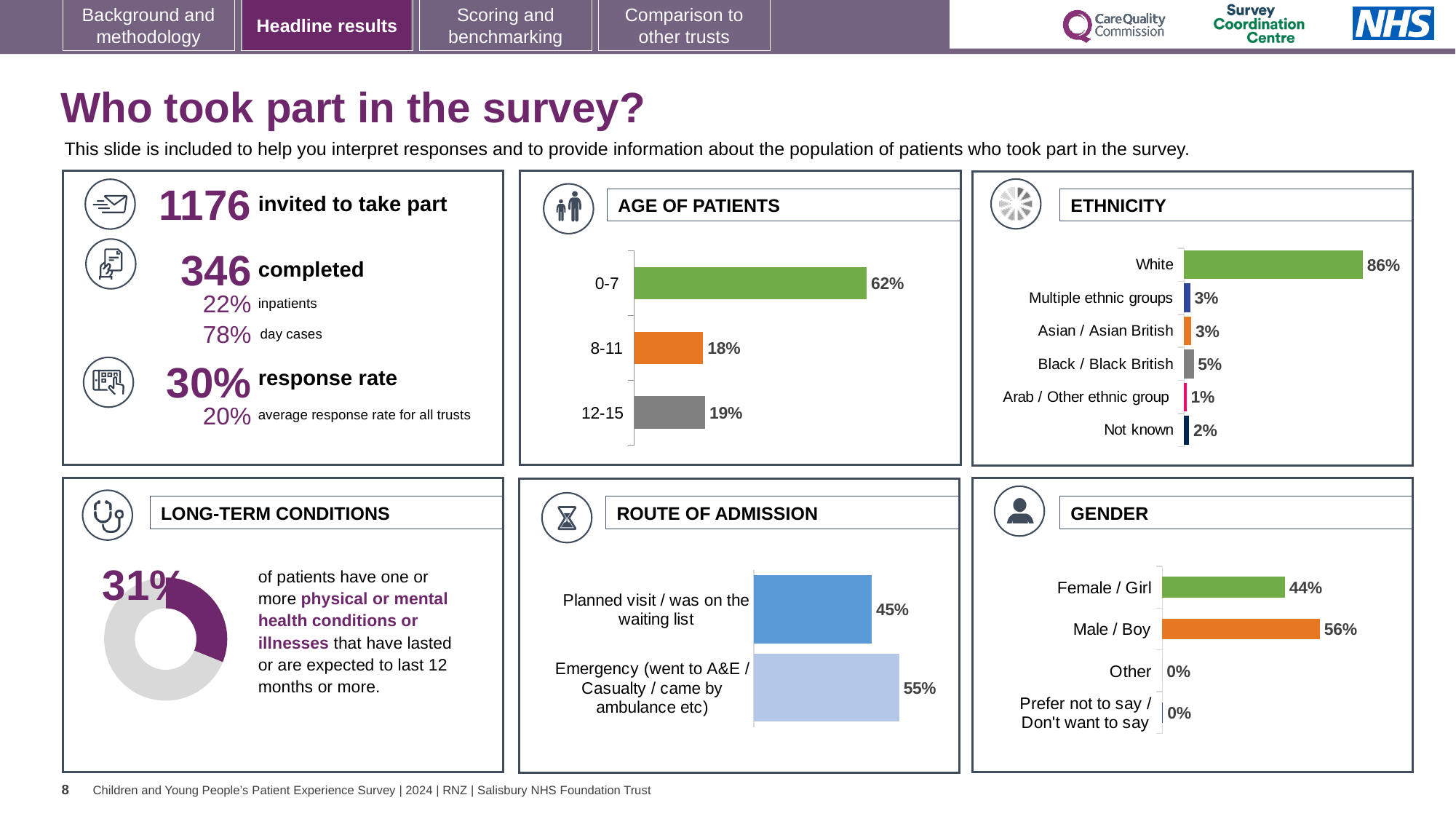
What type of chart is used in the LONG-TERM CONDITIONS panel? Doughnut chart In the AGE OF PATIENTS chart, which age group has the lowest percentage? 8-11 In the ETHNICITY chart, how many ethnicity categories are listed? 6 In the ROUTE OF ADMISSION chart, which route has the larger percentage: Planned visit / was on the waiting list or Emergency? Emergency (went to A&E / Casualty / came by ambulance etc) In the AGE OF PATIENTS chart, what percentage of patients are aged 0-7? 62% In the ETHNICITY chart, what percentage of patients are White? 86% In the ROUTE OF ADMISSION chart, what percentage of patients came via Emergency (went to A&E / Casualty / came by ambulance etc)? 55% In the GENDER chart, what percentage of patients are Male / Boy? 56% In the ETHNICITY chart, which category has the lowest percentage? Arab / Other ethnic group In the GENDER chart, what is the difference between the Male / Boy and Female / Girl percentages? 12% In the ETHNICITY chart, what is the difference between the White and Black / Black British percentages? 81% In the AGE OF PATIENTS chart, how many age groups are shown? 3